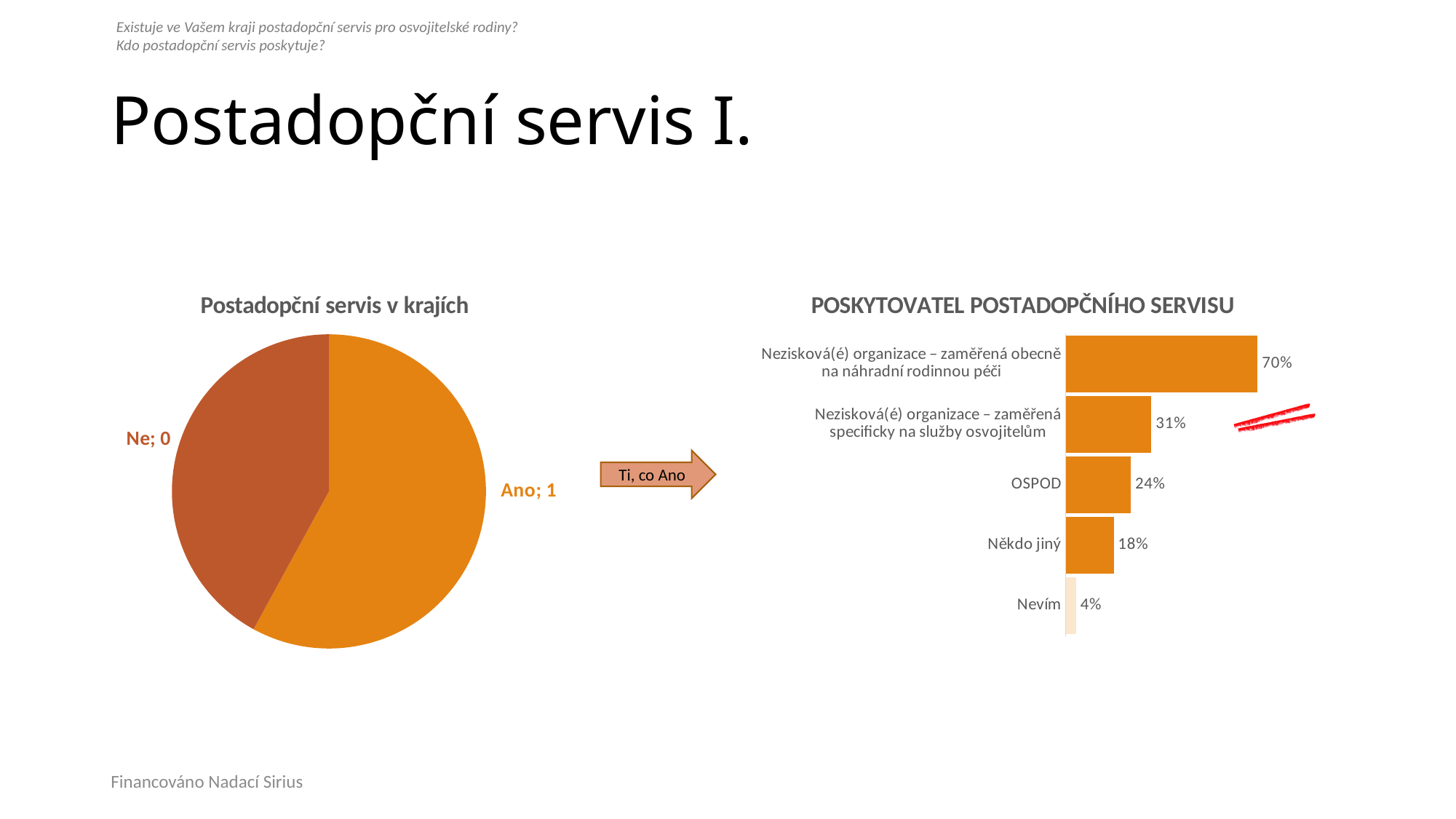
In the chart titled 'POSKYTOVATEL POSTADOPČNÍHO SERVISU', what is the value for 'Nevím'? 4% In the chart titled 'POSKYTOVATEL POSTADOPČNÍHO SERVISU', what is the value for 'Nezisková(é) organizace – zaměřená specificky na služby osvojitelům'? 31% In the chart titled 'POSKYTOVATEL POSTADOPČNÍHO SERVISU', what is the difference between the value for 'Nezisková(é) organizace – zaměřená obecně na náhradní rodinnou péči' and the value for OSPOD? 46% In the chart titled 'POSKYTOVATEL POSTADOPČNÍHO SERVISU', what is the value for 'Někdo jiný'? 18% How many categories are shown in the chart titled 'POSKYTOVATEL POSTADOPČNÍHO SERVISU'? 5 In the pie chart titled 'Postadopční servis v krajích', which slice is larger: 'Ano' or 'Ne'? Ano In the chart titled 'POSKYTOVATEL POSTADOPČNÍHO SERVISU', which category has the lowest value? Nevím In the chart titled 'POSKYTOVATEL POSTADOPČNÍHO SERVISU', what is the value for OSPOD? 24% What kind of chart is the chart titled 'Postadopční servis v krajích'? Pie chart In the chart titled 'POSKYTOVATEL POSTADOPČNÍHO SERVISU', which category has the highest value? Nezisková(é) organizace – zaměřená obecně na náhradní rodinnou péči What kind of chart is the chart titled 'POSKYTOVATEL POSTADOPČNÍHO SERVISU'? Bar chart In the chart titled 'POSKYTOVATEL POSTADOPČNÍHO SERVISU', which is larger: the value for OSPOD or the value for 'Někdo jiný'? OSPOD